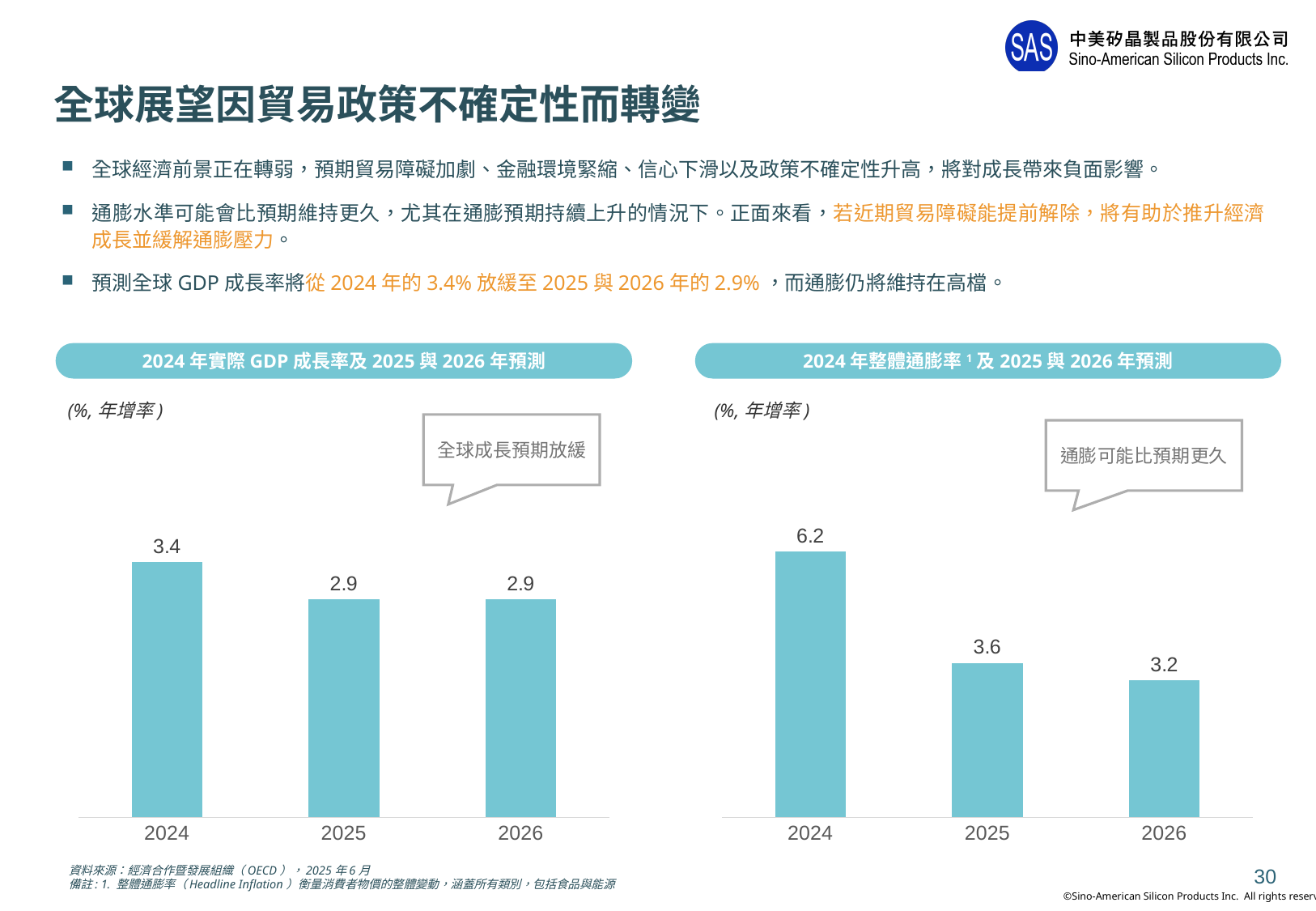
In the left chart (2024 年實際 GDP 成長率及 2025 與 2026 年預測), what is the value for 2026? 2.9 In the right chart (2024 年整體通膨率及 2025 與 2026 年預測), which year has the highest value? 2024 In the right chart (2024 年整體通膨率及 2025 與 2026 年預測), which year has the lowest value? 2026 In the right chart (2024 年整體通膨率及 2025 與 2026 年預測), which is larger, the value for 2025 or the value for 2026? 2025 In the right chart (2024 年整體通膨率及 2025 與 2026 年預測), what is the value for 2024? 6.2 In the left chart (2024 年實際 GDP 成長率及 2025 與 2026 年預測), what is the difference between the 2024 and 2025 values? 0.5 In the left chart (2024 年實際 GDP 成長率及 2025 與 2026 年預測), what is the value for 2024? 3.4 What kind of chart is the right chart (2024 年整體通膨率及 2025 與 2026 年預測)? Bar chart In the right chart (2024 年整體通膨率及 2025 與 2026 年預測), what is the difference between the 2024 and 2026 values? 3.0 In the right chart (2024 年整體通膨率及 2025 與 2026 年預測), do the values rise or fall from 2024 to 2026? Fall How many years are shown in the left chart (2024 年實際 GDP 成長率及 2025 與 2026 年預測)? 3 In the right chart (2024 年整體通膨率及 2025 與 2026 年預測), what is the value for 2025? 3.6